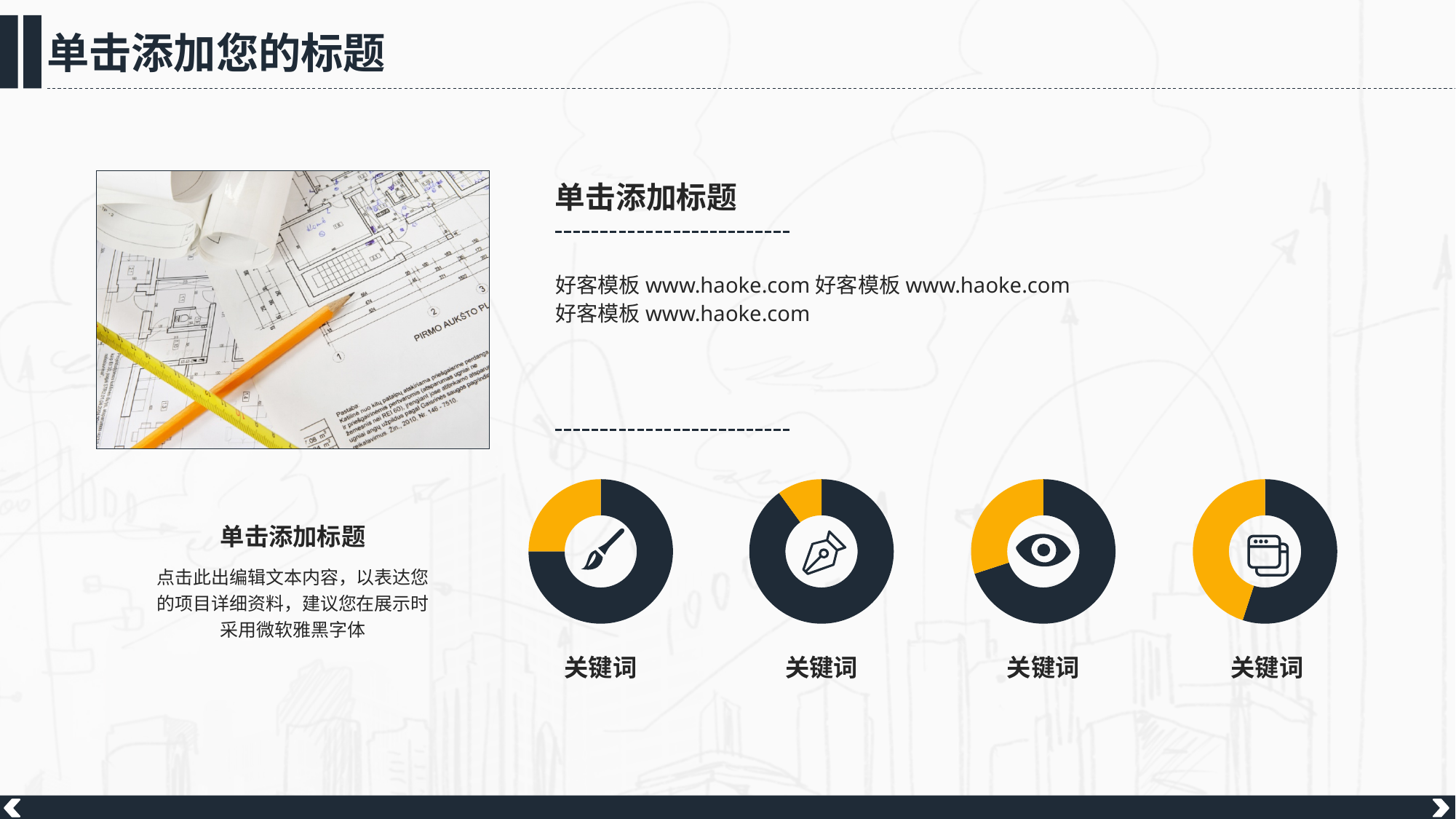
Is the yellow segment of the fourth (rightmost) donut chart larger or smaller than the yellow segment of the third donut chart? Larger Which donut chart, counting from the left, has the largest yellow segment? The fourth (rightmost) In the first (leftmost) donut chart, which segment is larger, the yellow or the dark one? The dark one How many donut charts are shown on the slide? 4 In the second donut chart from the left, which segment is larger, the yellow or the dark one? The dark one What two colours are used for the segments of the donut charts? Yellow and dark navy Which donut chart, counting from the left, has the smallest yellow segment? The second How many segments does each donut chart have? 2 What kind of chart is used for the four charts at the bottom right of the slide? Donut (pie) chart What label appears beneath each of the four donut charts? 关键词